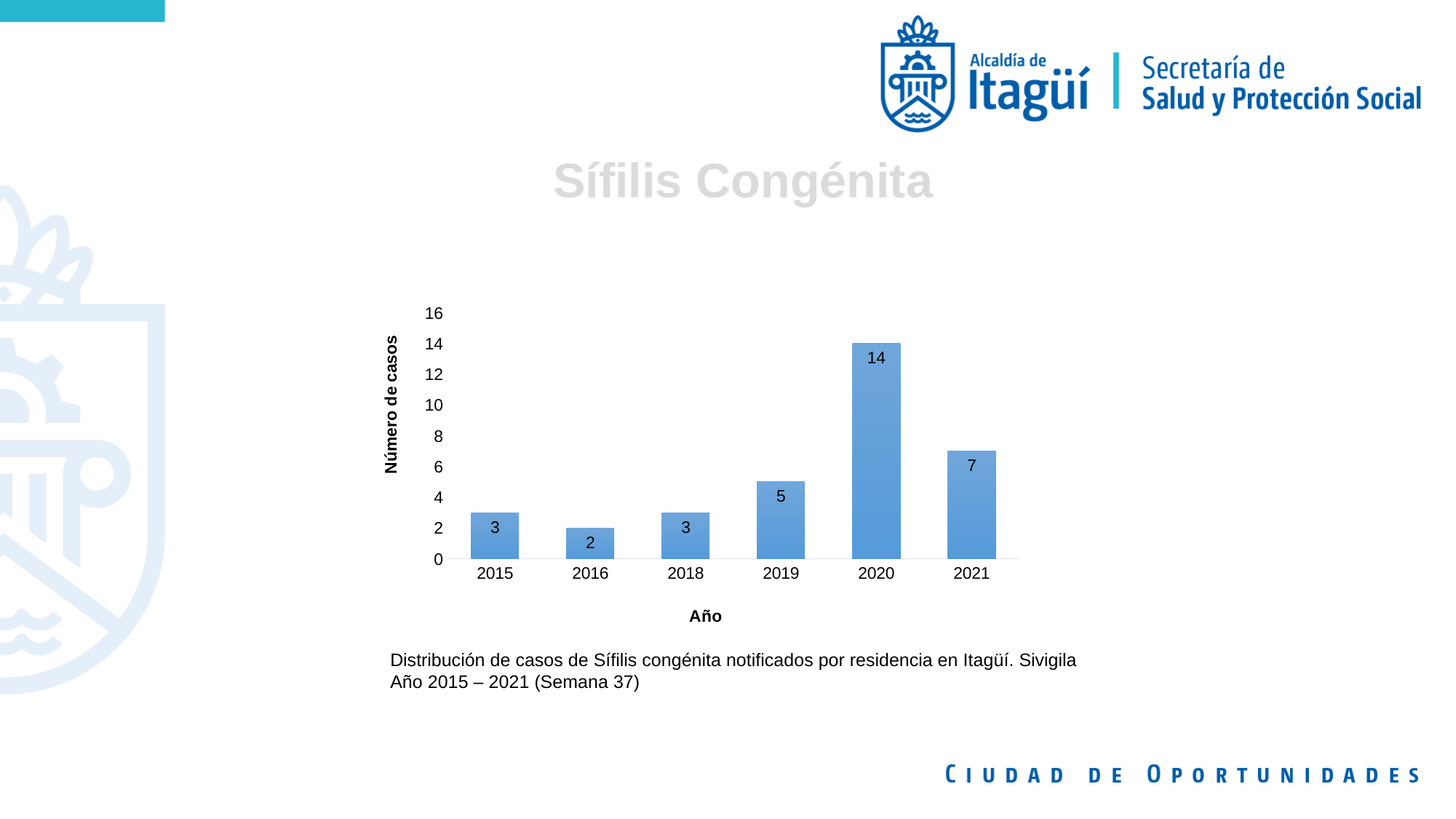
What is the number of cases for 2016? 2 How many years are shown on the x axis? 6 What is the difference in cases between 2020 and 2021? 7 How many cases are shown for 2020? 14 What is the value for 2021? 7 What is the label of the y axis? Número de casos Is the value for 2020 greater or less than 12? greater What kind of chart is shown on the slide? Bar chart Which year has the highest number of cases? 2020 Which year has the lowest number of cases? 2016 Which year has more cases, 2019 or 2021? 2021 Do the values rise or fall from 2018 to 2020? Rise